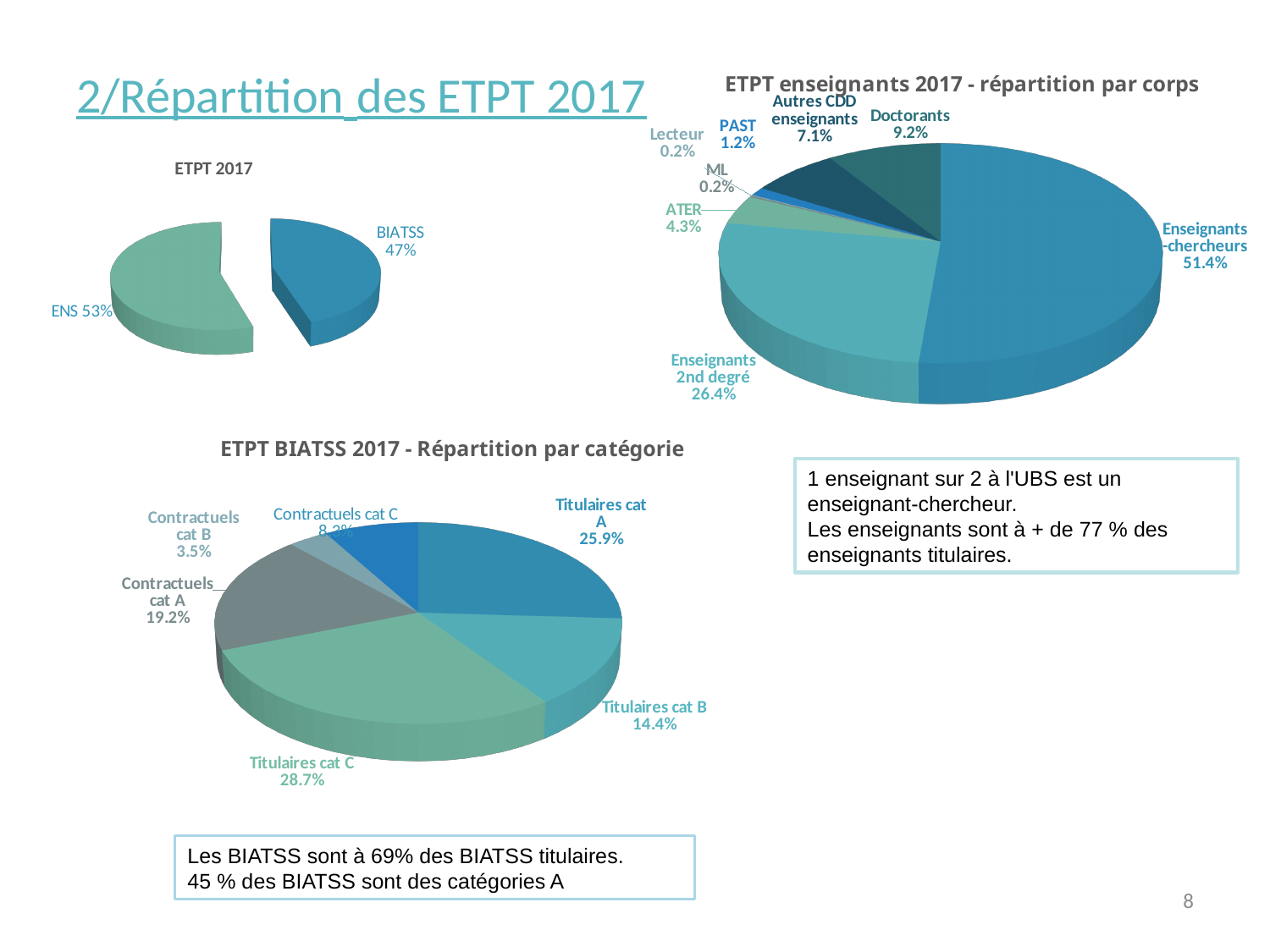
In the "ETPT 2017" chart, which is larger, ENS or BIATSS? ENS In the "ETPT enseignants 2017 - répartition par corps" chart, what share is Enseignants-chercheurs? 51.4% In the "ETPT enseignants 2017 - répartition par corps" chart, what share is Enseignants 2nd degré? 26.4% In the "ETPT 2017" chart, what share is ENS? 53% What kind of chart is "ETPT enseignants 2017 - répartition par corps"? Pie chart In the "ETPT enseignants 2017 - répartition par corps" chart, what is the difference between the Doctorants share and the ATER share? 4.9% In the "ETPT BIATSS 2017 - Répartition par catégorie" chart, what is the difference between Titulaires cat A and Titulaires cat B? 11.5% How many categories are shown in the "ETPT enseignants 2017 - répartition par corps" chart? 8 In the "ETPT 2017" chart, what share is BIATSS? 47% In the "ETPT enseignants 2017 - répartition par corps" chart, which corps has the largest share? Enseignants-chercheurs In the "ETPT BIATSS 2017 - Répartition par catégorie" chart, which category has the smallest share? Contractuels cat B In the "ETPT BIATSS 2017 - Répartition par catégorie" chart, what share is Titulaires cat C? 28.7%